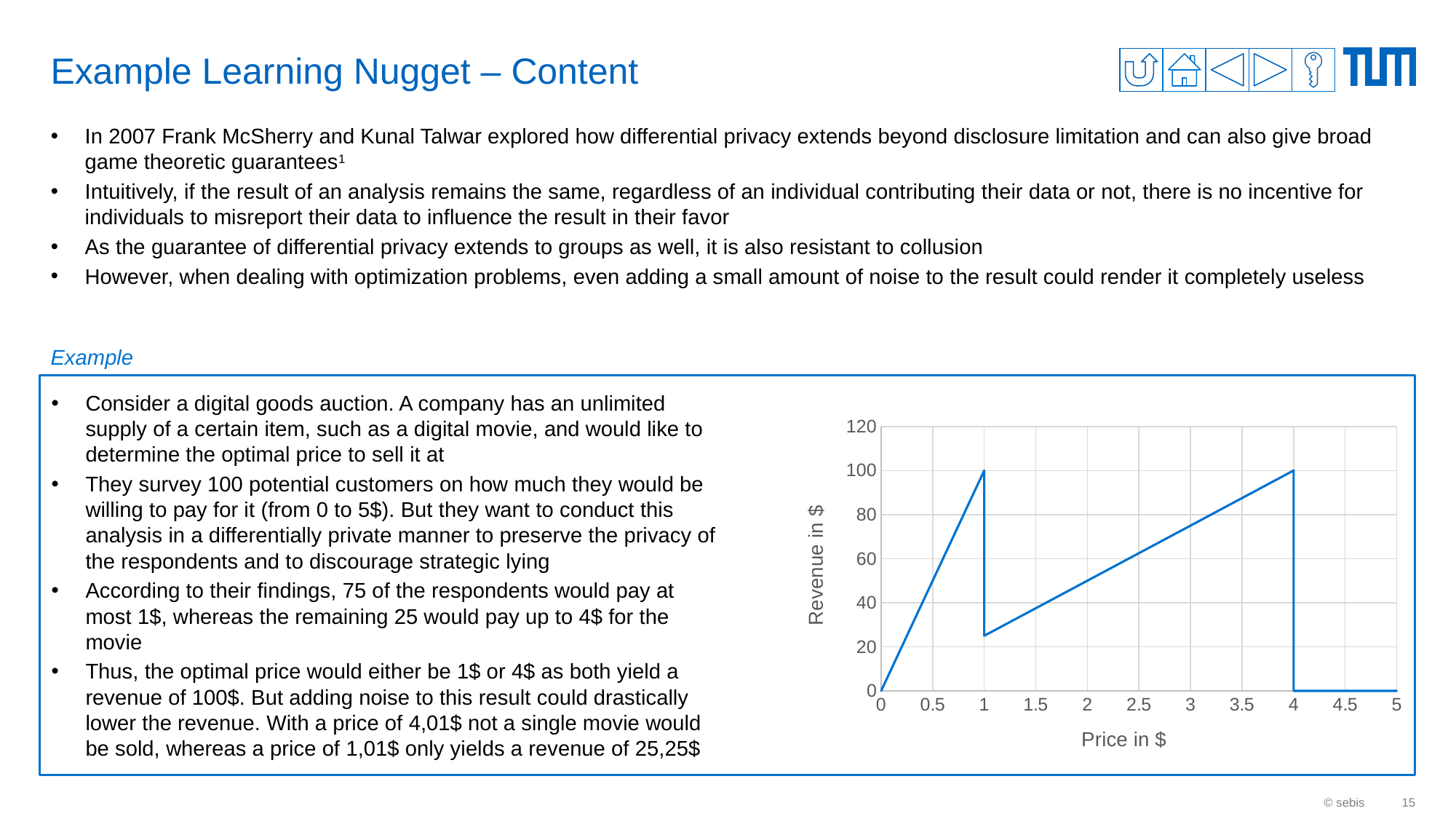
What is the highest value shown on the y axis of the chart? 120 Is the revenue at a price of 2 $ greater or less than 40? greater What is the revenue at a price of 1 $? 100 What is the label of the y axis of the chart? Revenue in $ What kind of chart is shown on the slide? line chart Is the revenue at a price of 3 $ greater or less than 60? greater Is the revenue at a price of 4.5 $ greater or less than 20? less What is the label of the x axis of the chart? Price in $ What is the revenue at a price of 0 $? 0 Between a price of 1.5 $ and 4 $, does the revenue rise or fall as the price increases? rise What is the revenue at a price of 4 $? 100 What is the revenue at a price of 5 $? 0